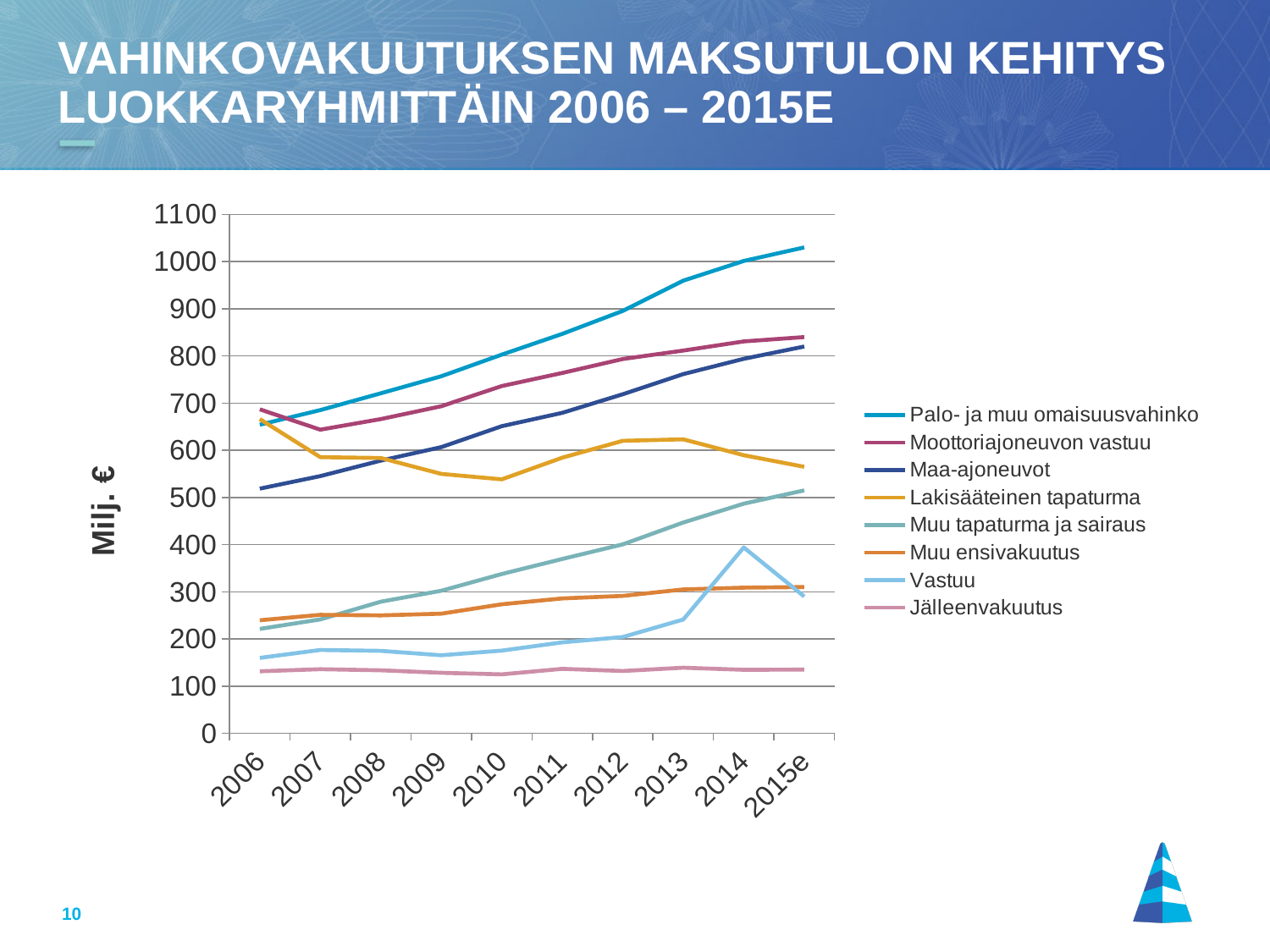
Does the Lakisääteinen tapaturma series rise or fall from 2013 to 2015e? fall Is the value for Vastuu in 2014 greater or less than 300? greater What is the label on the y axis? Milj. € How many series does the legend list? 8 What kind of chart is shown on the slide? line chart Which series has the lowest value in 2015e? Jälleenvakuutus In 2006, which is larger: Moottoriajoneuvon vastuu or Maa-ajoneuvot? Moottoriajoneuvon vastuu Does the Palo- ja muu omaisuusvahinko series rise or fall from 2006 to 2015e? rise Which series has the highest value in 2015e? Palo- ja muu omaisuusvahinko How many years are shown along the x axis? 10 Is the value for Palo- ja muu omaisuusvahinko in 2015e greater or less than 1000? greater Is the value for Maa-ajoneuvot in 2006 greater or less than 600? less